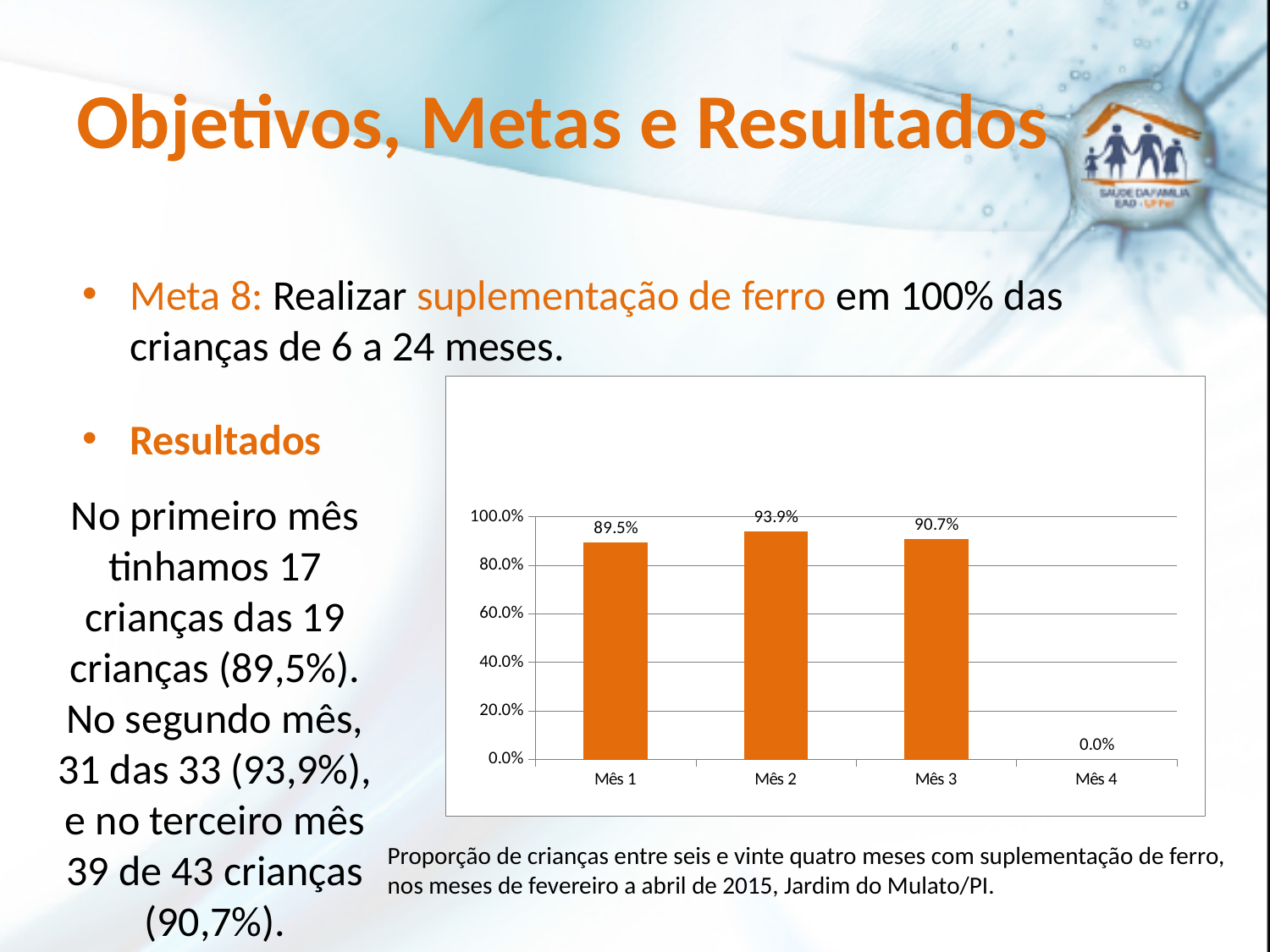
Which is larger, the value for Mês 2 or the value for Mês 3? Mês 2 What colour are the bars in the chart? orange Is the value for Mês 1 greater or less than 80.0%? greater What is the difference between the values for Mês 2 and Mês 1? 4.4% What kind of chart is shown on the slide? bar chart What is the value for Mês 2? 93.9% How many months are shown on the x axis? 4 What is the value for Mês 4? 0.0% Which month has the highest value? Mês 2 What is the value for Mês 1? 89.5% What is the value for Mês 3? 90.7% Which month has the lowest value? Mês 4